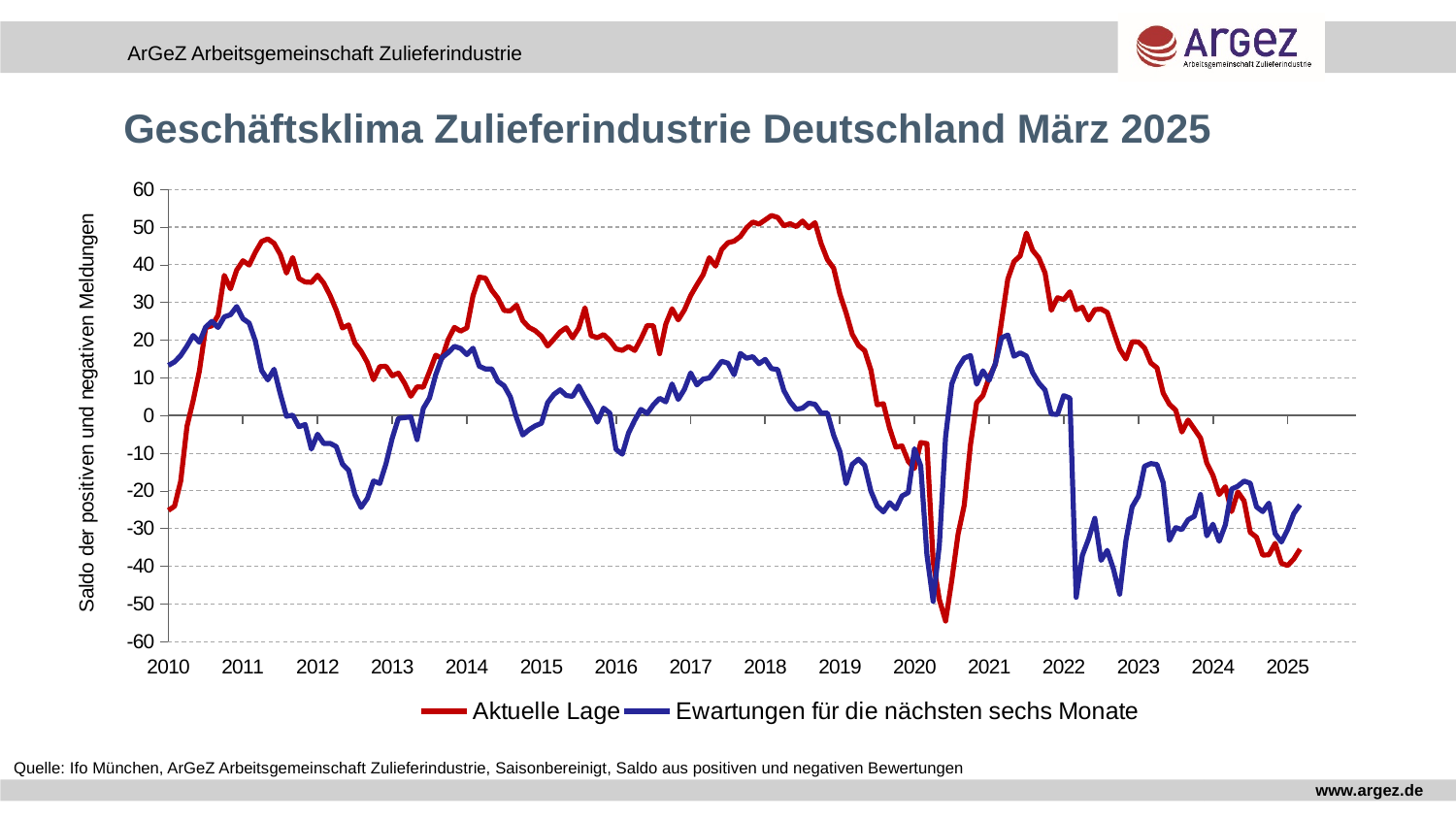
Is the value of Aktuelle Lage at the start of 2010 greater or less than 0? less Is the value of Aktuelle Lage at the end of the series in 2025 greater or less than -30? less How many series does the legend list? 2 At the end of the series in 2025, which series has the higher value, Aktuelle Lage or Ewartungen für die nächsten sechs Monate? Ewartungen für die nächsten sechs Monate Is the value of Ewartungen für die nächsten sechs Monate at the end of the series in 2025 greater or less than -30? greater Which series reaches the highest value anywhere on the chart? Aktuelle Lage What kind of chart is shown on the slide? line chart Does the Aktuelle Lage line rise or fall from 2022 to 2025? fall Which series is drawn in red? Aktuelle Lage What is the title of the chart? Geschäftsklima Zulieferindustrie Deutschland März 2025